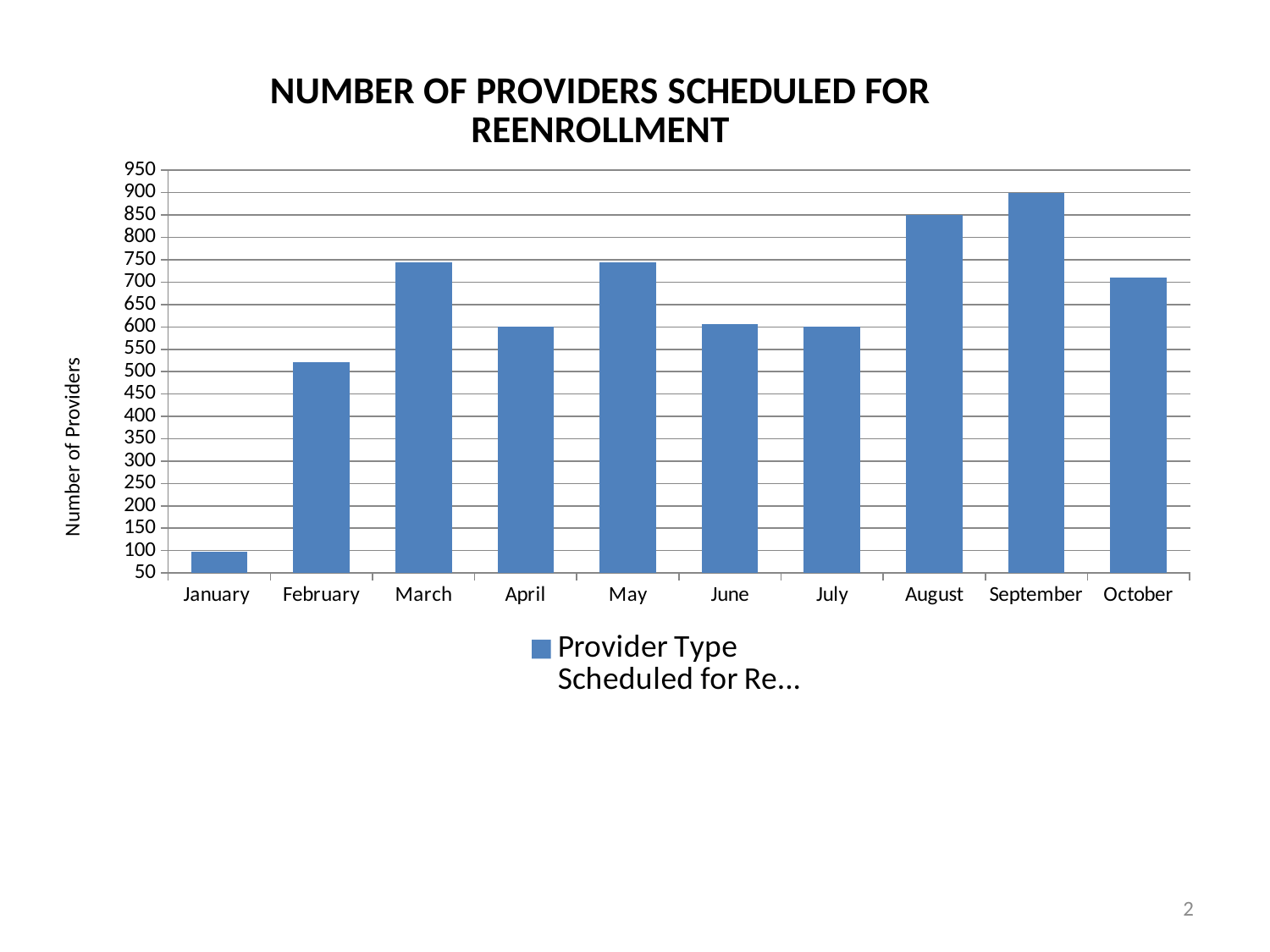
What kind of chart is shown on the slide? Bar chart What is the value for September? 900 What is the value for August? 850 Which is larger, the value for August or the value for October? August How many months are shown on the x axis? 10 Is the value for March greater or less than 700? greater Which month has the highest number of providers scheduled for reenrollment? September Do the values rise or fall from January to March? rise Is the value for February greater or less than 550? less What is the title of the vertical axis? Number of Providers Which month has the lowest number of providers scheduled for reenrollment? January How many series does the legend list? 1